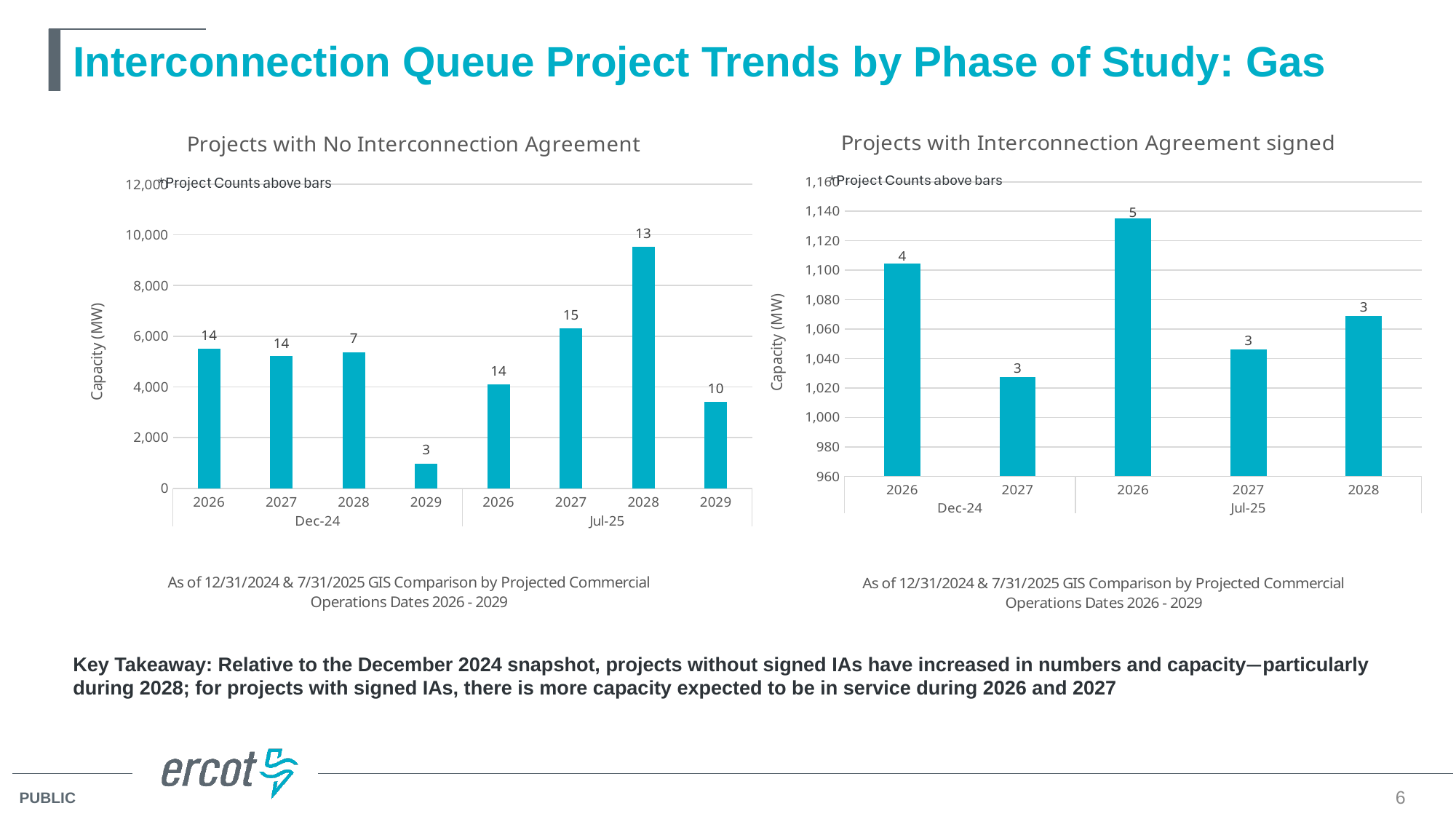
In the 'Projects with Interconnection Agreement signed' chart, what project count is shown above the 2026 bar in the Jul-25 group? 5 In the 'Projects with No Interconnection Agreement' chart, which bar has the lowest capacity? 2029 in the Dec-24 group In the 'Projects with No Interconnection Agreement' chart, what project count is shown above the 2029 bar in the Dec-24 group? 3 What type of chart is the 'Projects with Interconnection Agreement signed' chart? bar chart In the 'Projects with Interconnection Agreement signed' chart, which bar has the lowest capacity? 2027 in the Dec-24 group In the 'Projects with No Interconnection Agreement' chart, what project count is shown above the 2028 bar in the Jul-25 group? 13 In the 'Projects with No Interconnection Agreement' chart, which bar has the highest capacity? 2028 in the Jul-25 group In the 'Projects with No Interconnection Agreement' chart, how many more projects are counted for 2027 in the Jul-25 group than for 2027 in the Dec-24 group? 1 In the 'Projects with Interconnection Agreement signed' chart, is the capacity for 2026 in the Dec-24 group greater or less than 1,080? greater How many bars are plotted in the 'Projects with No Interconnection Agreement' chart? 8 In the 'Projects with No Interconnection Agreement' chart, is the capacity for 2028 in the Jul-25 group greater or less than 8,000? greater In the 'Projects with No Interconnection Agreement' chart, which has the larger capacity: 2027 in the Dec-24 group or 2027 in the Jul-25 group? 2027 in the Jul-25 group